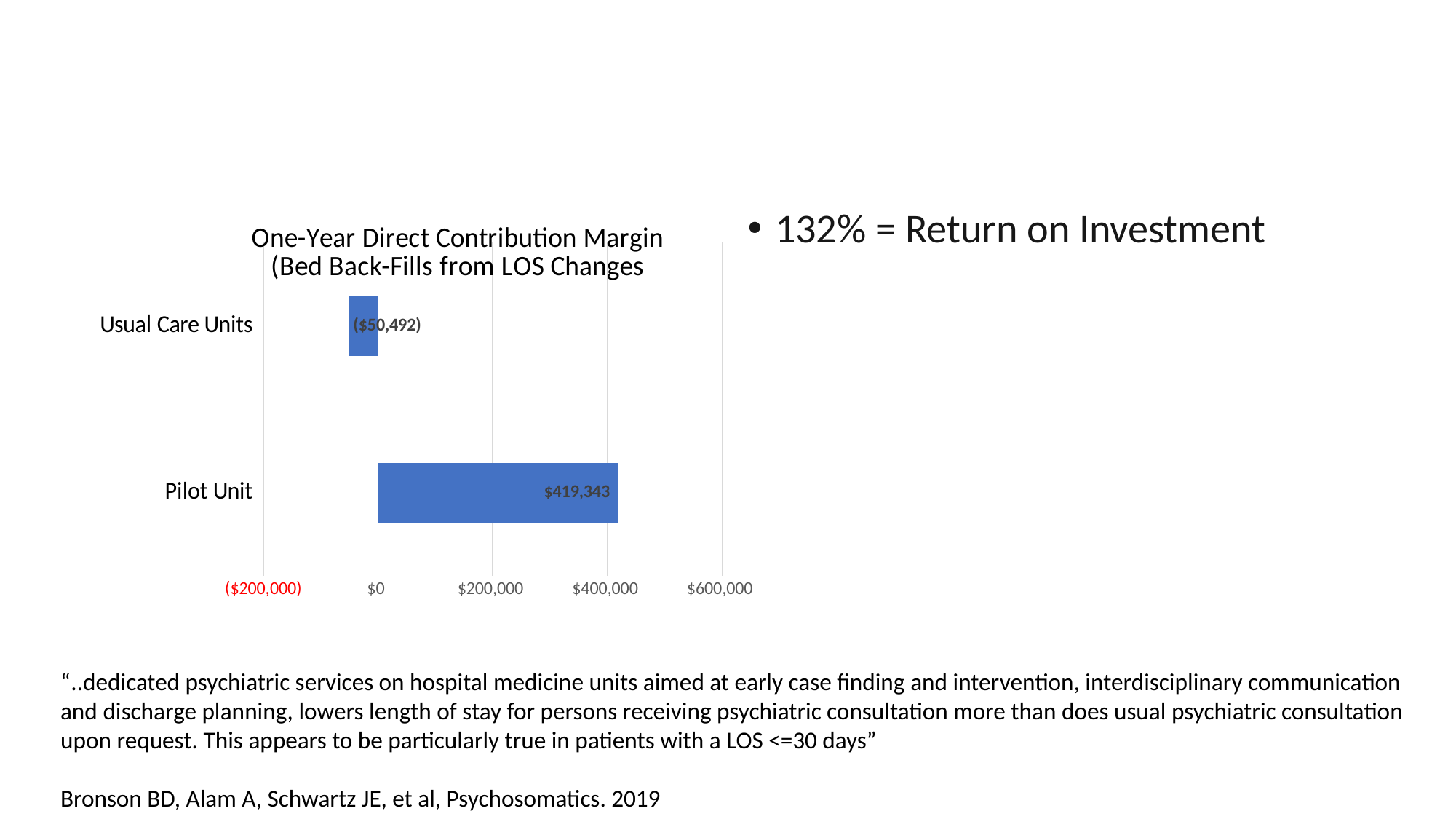
What is the title of the chart? One-Year Direct Contribution Margin (Bed Back-Fills from LOS Changes What is the lowest value shown on the chart's horizontal axis? ($200,000) Which category has the lowest one-year direct contribution margin? Usual Care Units Is the contribution margin for the Pilot Unit larger or smaller than that for the Usual Care Units? larger Is the value for the Usual Care Units greater or less than $0? less Which category has the highest one-year direct contribution margin? Pilot Unit What kind of chart is shown on the slide? bar chart How many categories are shown in the chart? 2 What is the difference between the Pilot Unit's contribution margin and the Usual Care Units' contribution margin? $469,835 Is the value for the Pilot Unit greater or less than $400,000? greater What is the one-year direct contribution margin for the Pilot Unit? $419,343 What is the one-year direct contribution margin for the Usual Care Units? ($50,492)